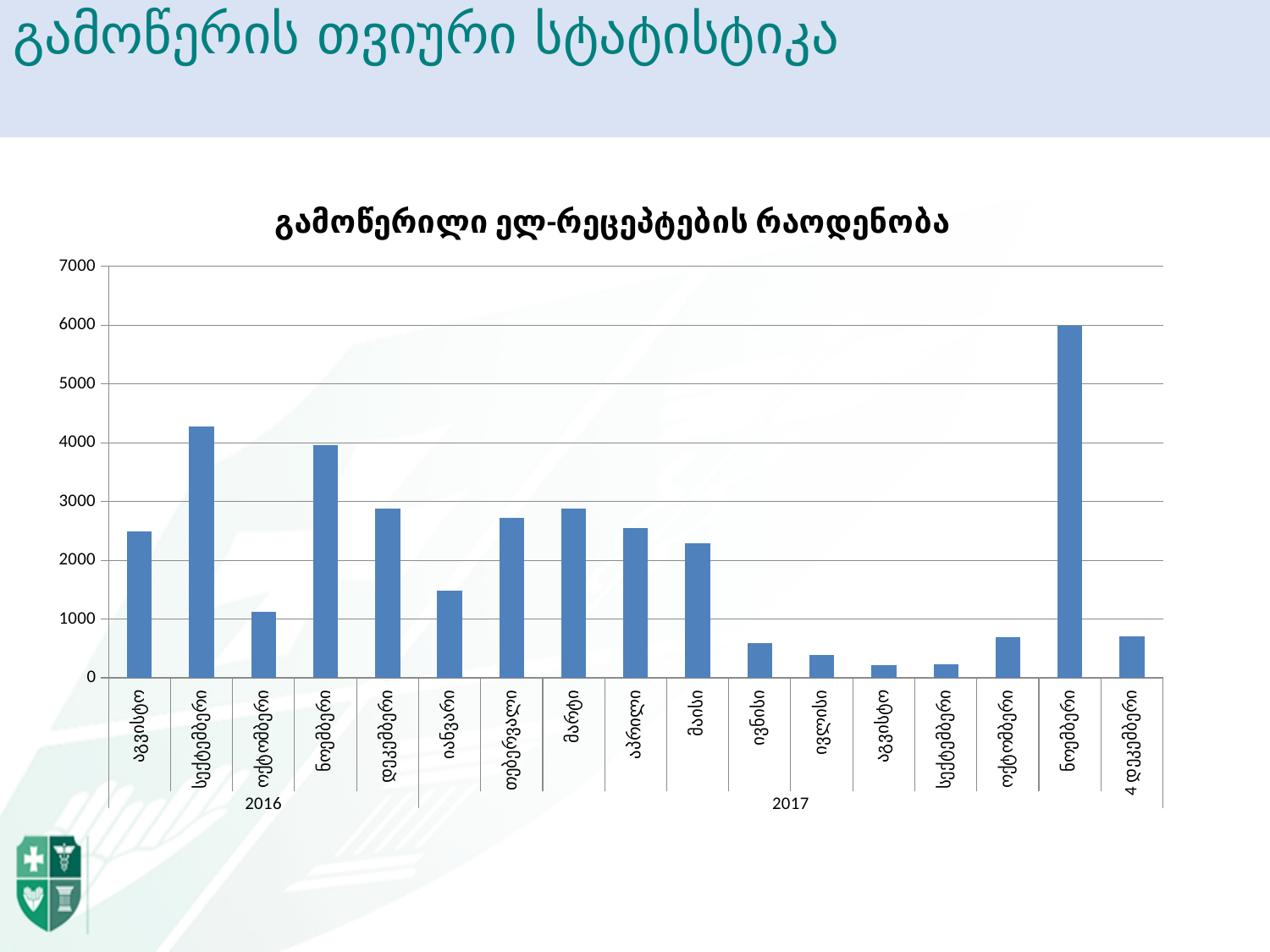
Is the value for ნოემბერი 2017 greater or less than 5000? greater Is the value for ივნისი 2017 greater or less than 1000? less Which is larger, the value for სექტემბერი 2016 or the value for ნოემბერი 2016? სექტემბერი 2016 How many bars (months) are plotted in the chart? 17 Which is larger, the value for აგვისტო 2016 or the value for ოქტომბერი 2016? აგვისტო 2016 What kind of chart is shown on the slide? bar chart Which two years are labelled on the x axis of the chart? 2016 and 2017 Do the values rise or fall from მარტი 2017 to ივლისი 2017? fall Is the value for ოქტომბერი 2016 greater or less than 2000? less Which month has the highest number of e-prescriptions in the chart? ნოემბერი (2017) What is the title of the chart? გამოწერილი ელ-რეცეპტების რაოდენობა